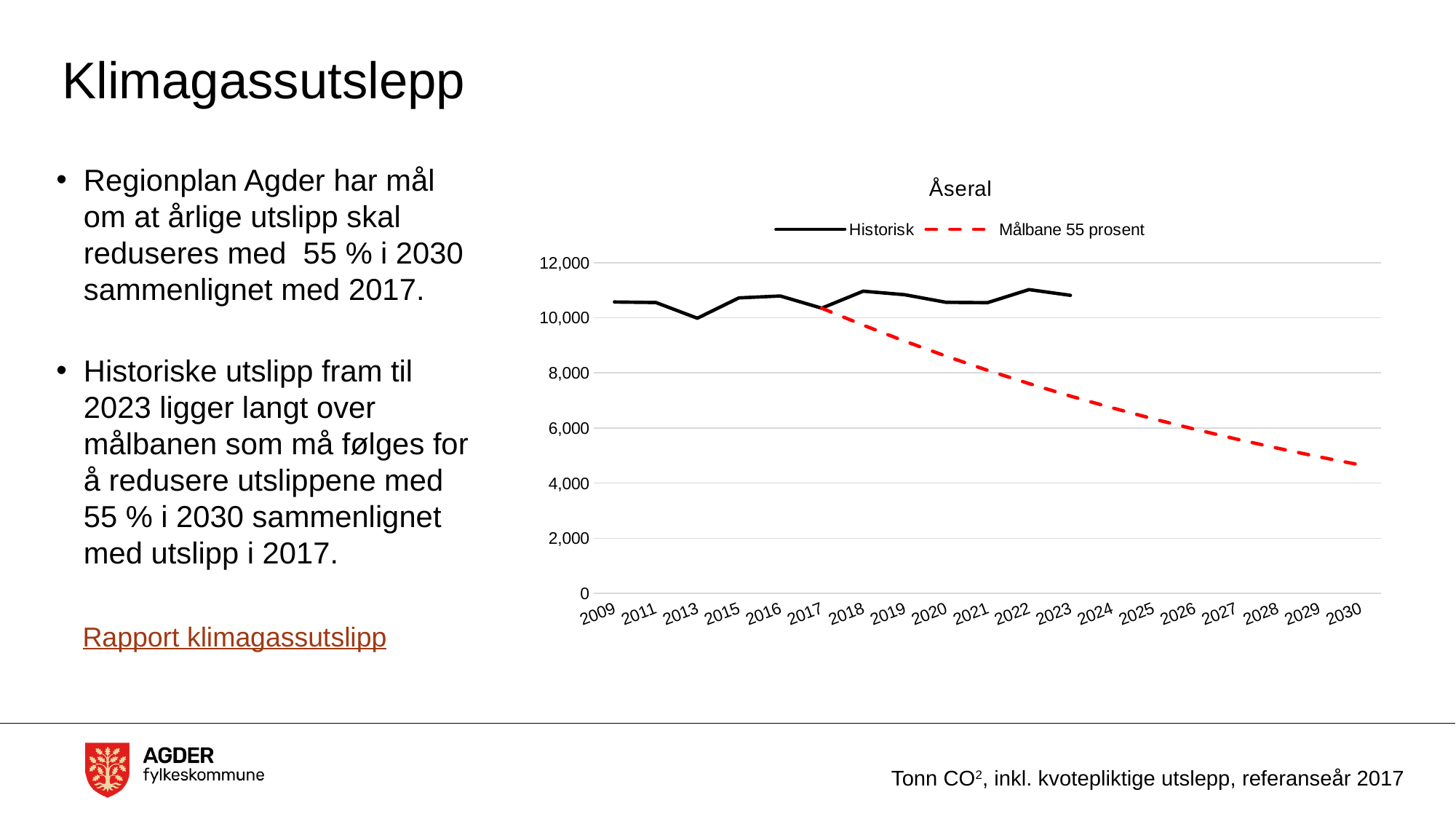
What is the title of the chart? Åseral In 2023, which series has the higher value, Historisk or Målbane 55 prosent? Historisk How many years are labelled on the x axis of the chart? 19 Is the Historisk value for 2022 greater or less than 10,000? greater Is the Målbane 55 prosent value for 2030 greater or less than 6,000? less In which year is the Historisk series at its lowest? 2013 Is the Historisk value for 2013 greater or less than 8,000? greater Does the Målbane 55 prosent line rise or fall from 2017 to 2030? fall What kind of chart is shown on the slide? line chart Which series is drawn as a red dashed line? Målbane 55 prosent How many series does the legend of the chart list? 2